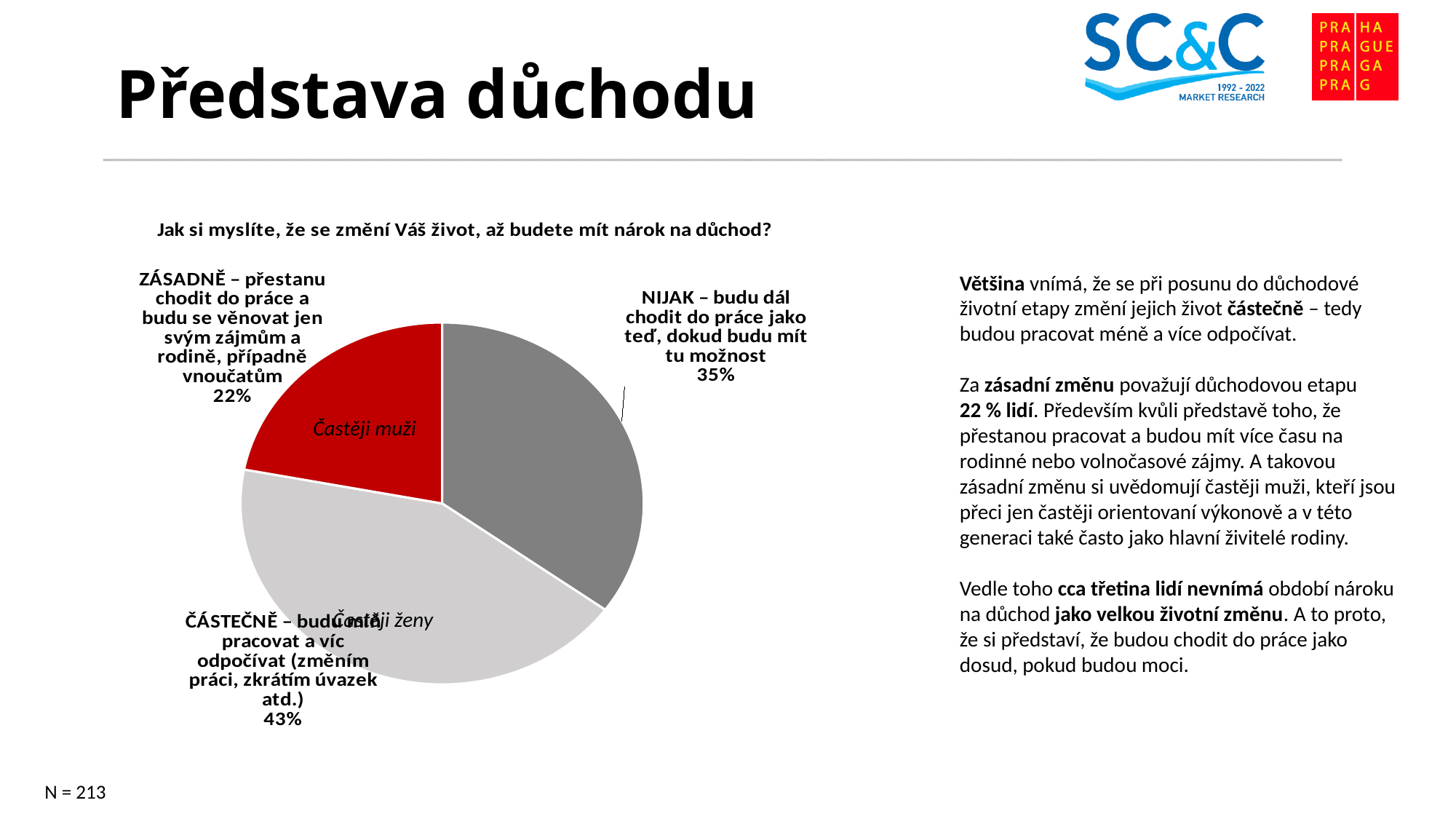
What colour is the "ZÁSADNĚ" slice of the pie? red Which answer category has the largest slice of the pie? ČÁSTEČNĚ – budu méně pracovat a víc odpočívat What share of respondents answered "ČÁSTEČNĚ – budu méně pracovat a víc odpočívat"? 43% Which answer category has the smallest slice of the pie? ZÁSADNĚ – přestanu chodit do práce Which is larger: the "NIJAK" slice or the "ZÁSADNĚ" slice? NIJAK What is the difference in percentage points between the "NIJAK" slice and the "ZÁSADNĚ" slice? 13 percentage points What share of respondents answered "ZÁSADNĚ – přestanu chodit do práce a budu se věnovat jen svým zájmům a rodině, případně vnoučatům"? 22% What kind of chart is shown on the slide? pie chart What is the difference in percentage points between the "ČÁSTEČNĚ" slice and the "NIJAK" slice? 8 percentage points What is the question shown as the title of the pie chart? Jak si myslíte, že se změní Váš život, až budete mít nárok na důchod? What share of respondents answered "NIJAK – budu dál chodit do práce jako teď, dokud budu mít tu možnost"? 35% How many slices does the pie chart have? 3